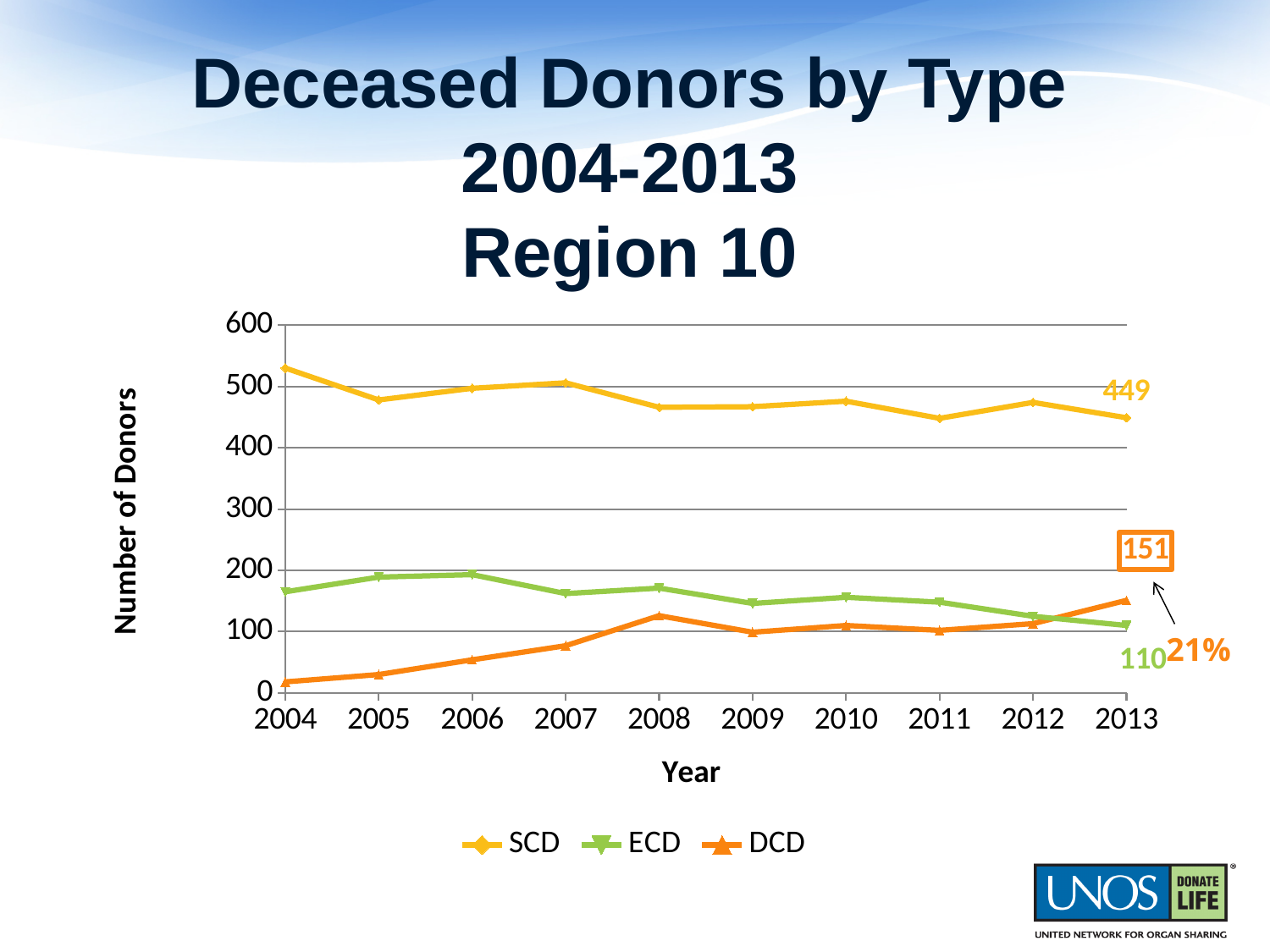
How many years are plotted along the x axis? 10 What is the number of ECD donors in 2013? 110 In 2013, which is larger: the DCD value or the ECD value? DCD What is the difference between the SCD and DCD values in 2013? 298 Which series has the highest value in 2013? SCD What is the number of DCD donors in 2013? 151 What is the number of SCD donors in 2013? 449 Is the DCD value for 2004 greater or less than 100? less How many series does the legend list? 3 Does the DCD series generally rise or fall from 2004 to 2013? rise What type of chart is shown on the slide? line chart Is the SCD value for 2004 greater or less than 500? greater